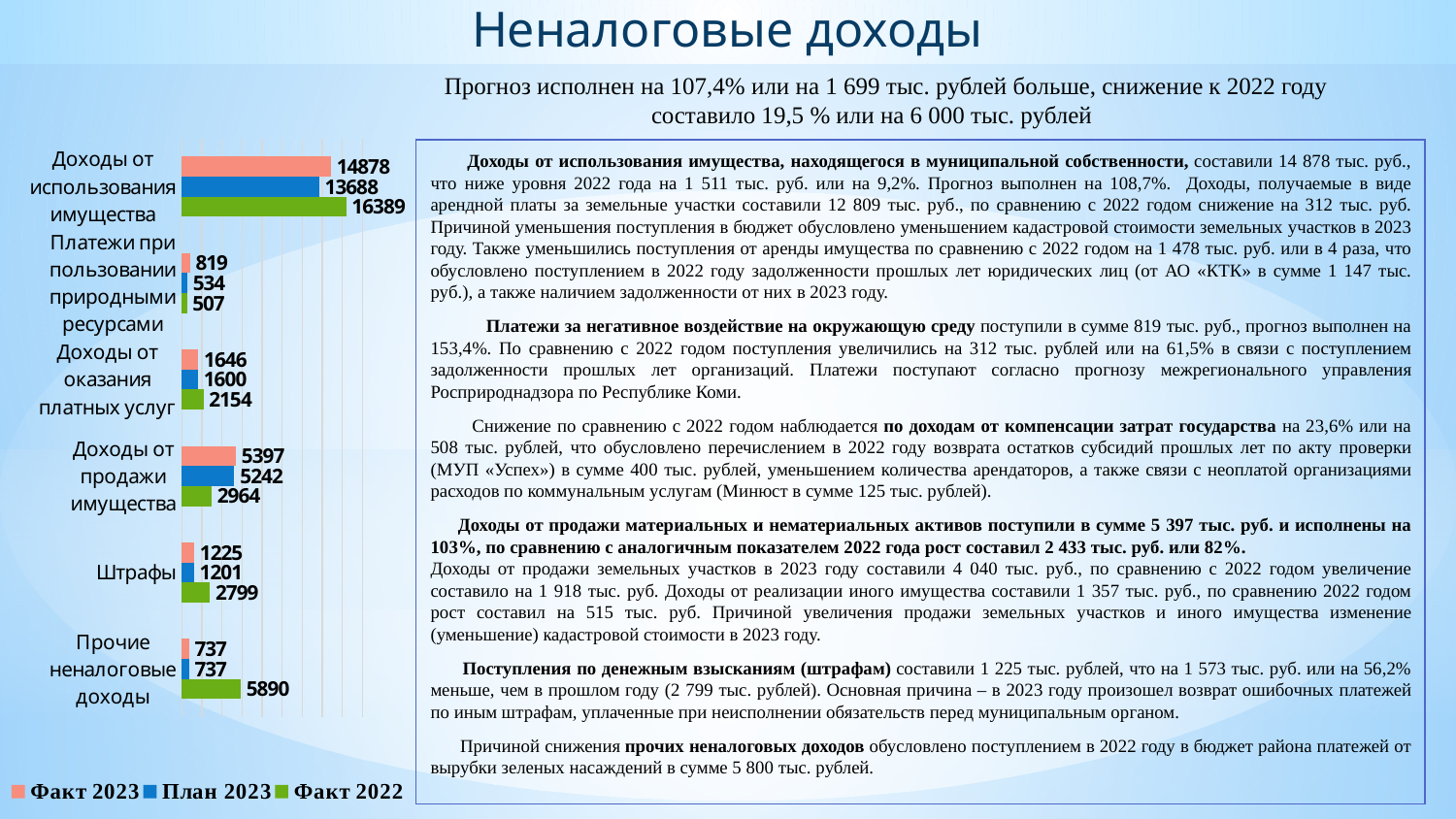
В какой категории значение «Факт 2022» наименьшее? Платежи при пользовании природными ресурсами Какое значение показателя «Факт 2022» для категории «Прочие неналоговые доходы»? 5890 Какое значение показателя «Факт 2023» для категории «Доходы от использования имущества»? 14878 Что больше для категории «Доходы от продажи имущества»: «Факт 2023» или «Факт 2022»? Факт 2023 Сколько рядов данных перечислено в легенде диаграммы? 3 Какое значение показателя «План 2023» для категории «Штрафы»? 1201 Сколько категорий показано на диаграмме? 6 Какого типа эта диаграмма? Столбчатая (линейчатая) диаграмма На сколько значение «Факт 2022» больше значения «Факт 2023» для категории «Доходы от использования имущества»? 1511 Что больше для категории «Штрафы»: «Факт 2023» или «Факт 2022»? Факт 2022 В какой категории значение «Факт 2023» наибольшее? Доходы от использования имущества Какое значение показателя «Факт 2023» для категории «Платежи при пользовании природными ресурсами»? 819